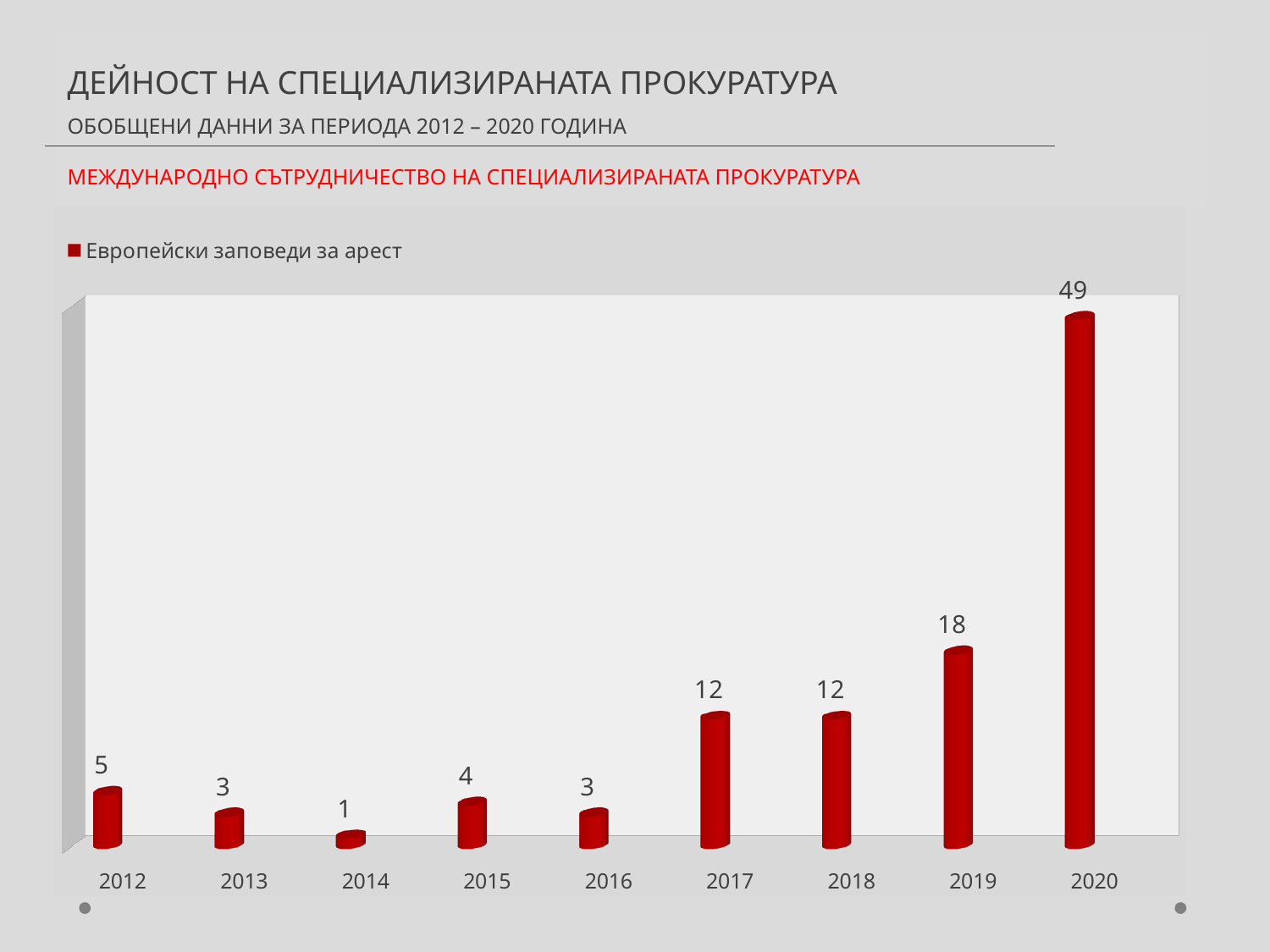
Which year has the lowest value? 2014 What is the value for 2014? 1 What kind of chart is shown? bar chart How many series does the legend list? 1 Which is larger, the value for 2015 or the value for 2016? 2015 What is the value for 2017? 12 Which year has the highest value? 2020 How many years are shown on the x axis? 9 What is the difference between the values for 2020 and 2019? 31 What is the value for 2020? 49 What is the legend entry for the series? Европейски заповеди за арест What is the difference between the values for 2012 and 2013? 2